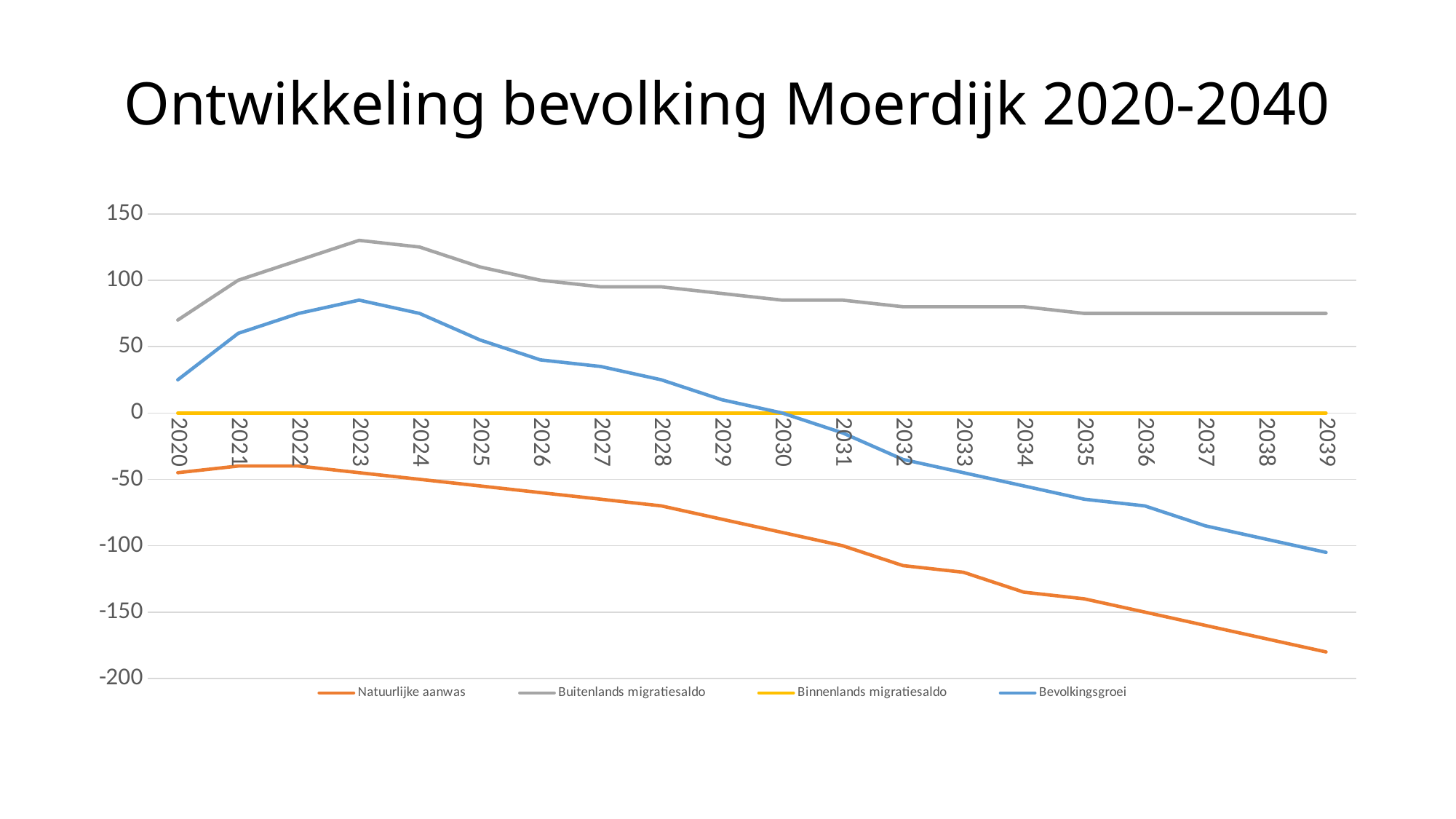
What is the value of Binnenlands migratiesaldo in 2030? 0 How many series does the legend list? 4 Does Natuurlijke aanwas rise or fall from 2023 to 2039? fall Is the value for Bevolkingsgroei in 2023 greater or less than 50? greater How many years are plotted along the x axis? 20 What is the title of the chart? Ontwikkeling bevolking Moerdijk 2020-2040 What kind of chart is shown on the slide? line chart In 2020, which is larger: Buitenlands migratiesaldo or Bevolkingsgroei? Buitenlands migratiesaldo Is the value for Natuurlijke aanwas in 2039 greater or less than -150? less In which year does Buitenlands migratiesaldo reach its highest value? 2023 Is the value for Buitenlands migratiesaldo in 2023 greater or less than 100? greater In which year is Bevolkingsgroei at its lowest? 2039